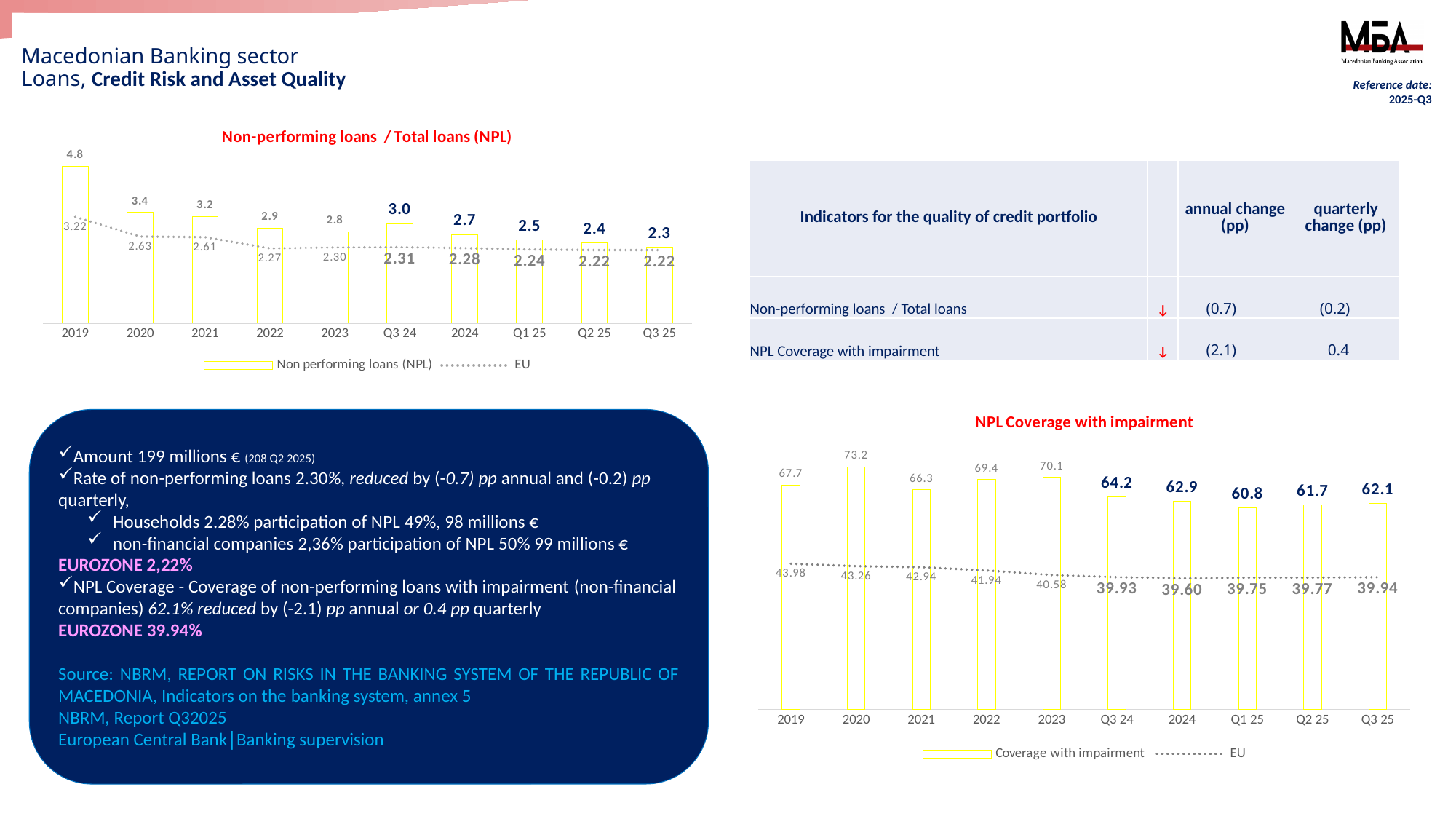
In the 'NPL Coverage with impairment' chart, what is the coverage value for 2020? 73.2 In the 'Non-performing loans / Total loans (NPL)' chart, what is the EU value for Q3 25? 2.22 In the 'NPL Coverage with impairment' chart, what is the EU value for 2023? 40.58 In the 'NPL Coverage with impairment' chart, what is the difference between the coverage values for 2020 and Q3 25? 11.1 What kind of chart is the 'NPL Coverage with impairment' chart? Bar chart with a line In the 'Non-performing loans / Total loans (NPL)' chart, what is the NPL value for 2019? 4.8 In the 'Non-performing loans / Total loans (NPL)' chart, which category has the highest NPL value? 2019 In the 'NPL Coverage with impairment' chart, which category has the lowest coverage value? Q1 25 In the 'Non-performing loans / Total loans (NPL)' chart, how many series does the legend list? 2 In the 'Non-performing loans / Total loans (NPL)' chart, how many categories are shown on the x axis? 10 In the 'NPL Coverage with impairment' chart, is the coverage value for 2024 larger or smaller than the value for Q3 24? smaller In the 'Non-performing loans / Total loans (NPL)' chart, what is the difference between the NPL values for 2019 and 2020? 1.4